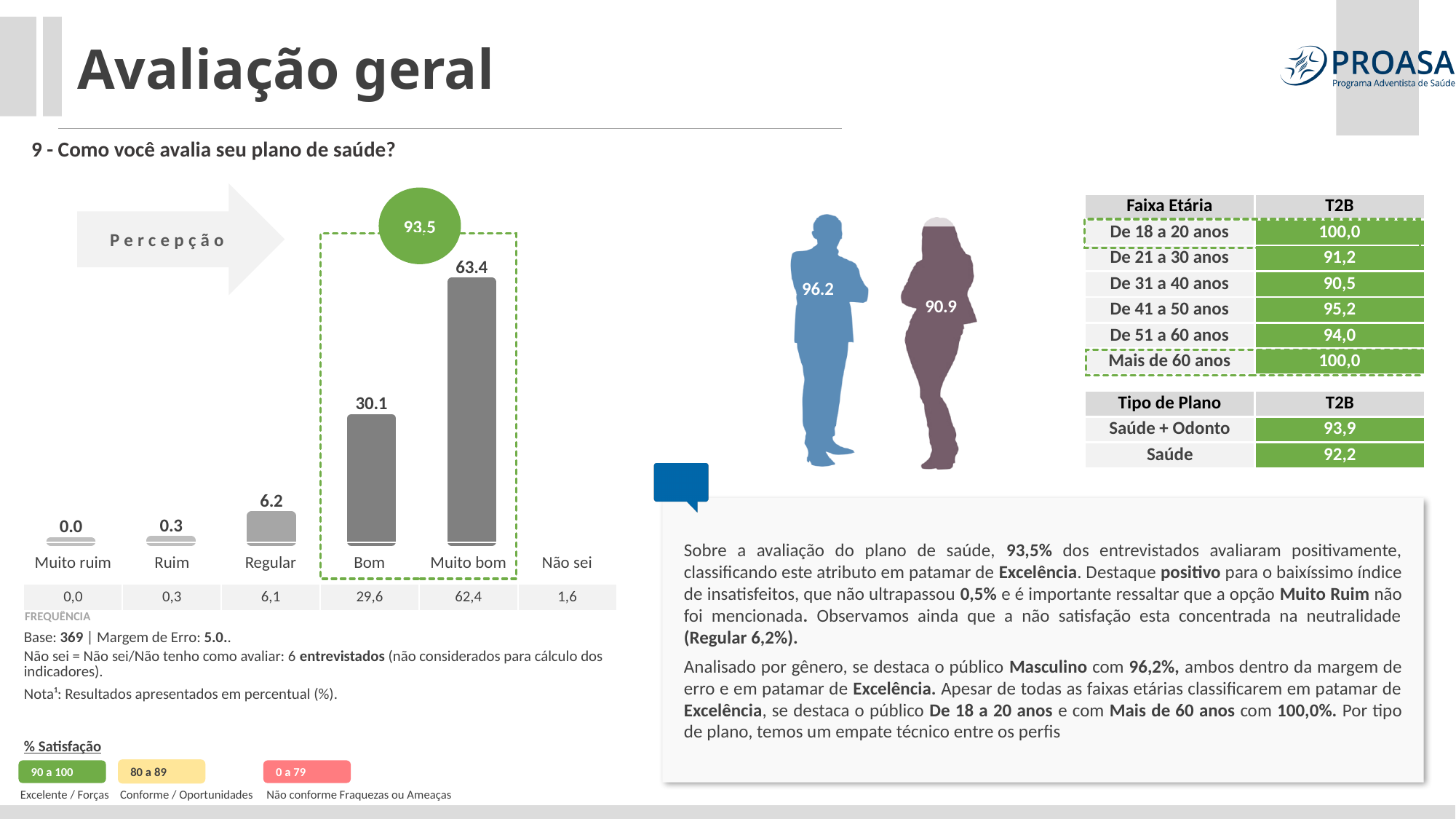
Which category has the highest value in the bar chart? Muito bom What is the difference between the 'Muito bom' and 'Bom' values in the chart? 33.3 Which category has the lowest value in the bar chart? Muito ruim How many category labels are shown along the x axis of the bar chart? 6 What is the value shown for the 'Ruim' bar in the chart? 0.3 Which is larger in the chart, the value for 'Regular' or the value for 'Bom'? Bom What value is shown in the green circle above the dashed box around 'Bom' and 'Muito bom'? 93.5 What is the value shown for the 'Regular' bar in the chart? 6.2 What is the value shown for the 'Muito bom' bar in the chart? 63.4 What is the value shown for the 'Bom' bar in the chart? 30.1 Do the bar values rise or fall from 'Muito ruim' to 'Muito bom' along the x axis? Rise What kind of chart is used to show the evaluation of the health plan? Bar chart